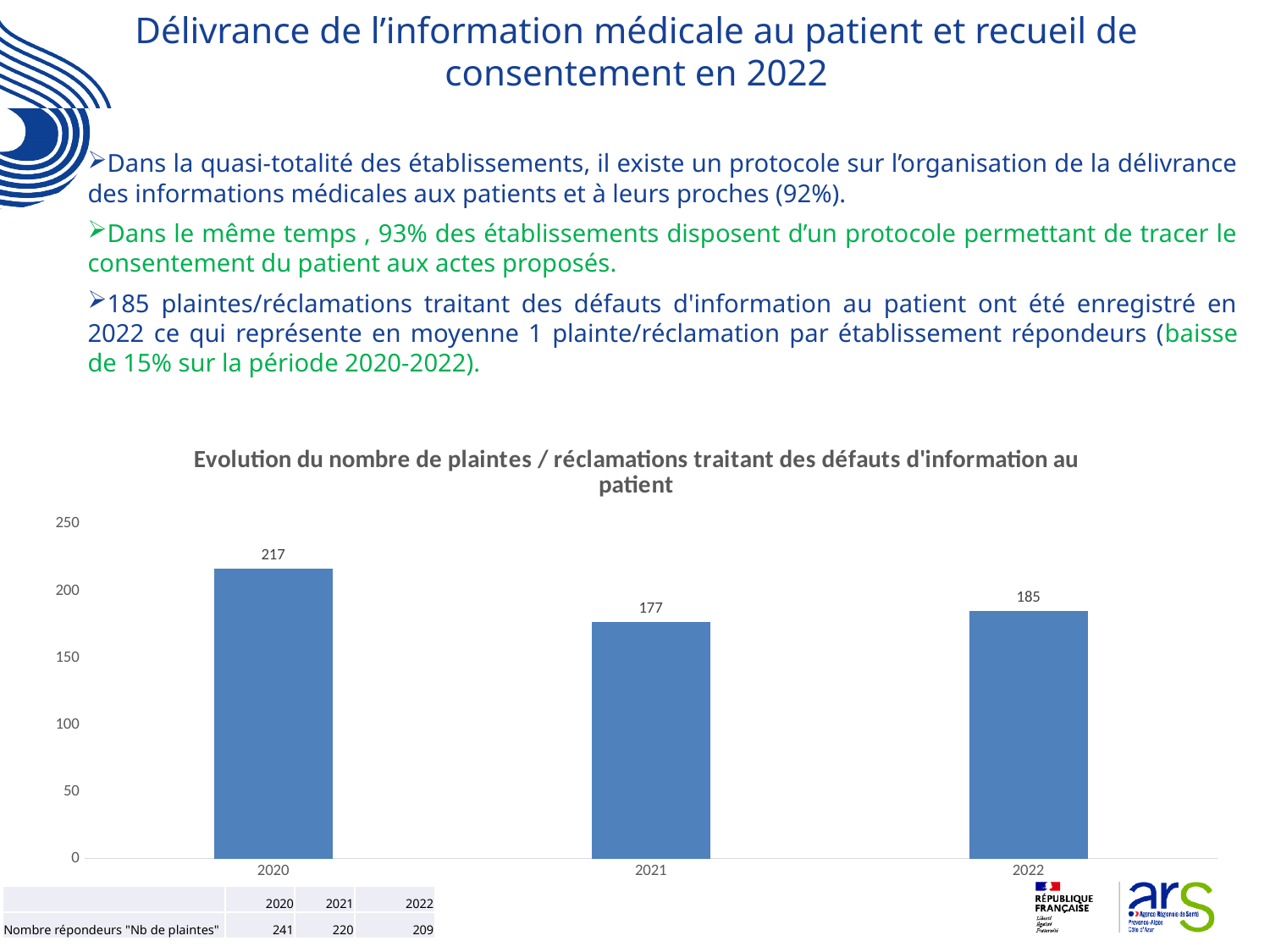
What is the number of complaints shown for 2020 in the chart? 217 Is the value for 2021 greater or less than 200? less Which year has the highest number of complaints in the chart? 2020 What is the difference between the number of complaints in 2022 and 2021? 8 What kind of chart is shown on the slide? bar chart Which year has the lowest number of complaints in the chart? 2021 Which year has more complaints, 2020 or 2022? 2020 What is the number of complaints shown for 2022 in the chart? 185 How many years are shown on the x axis of the chart? 3 What is the number of complaints shown for 2021 in the chart? 177 What is the difference between the number of complaints in 2020 and 2021? 40 What is the title of the chart? Evolution du nombre de plaintes / réclamations traitant des défauts d'information au patient